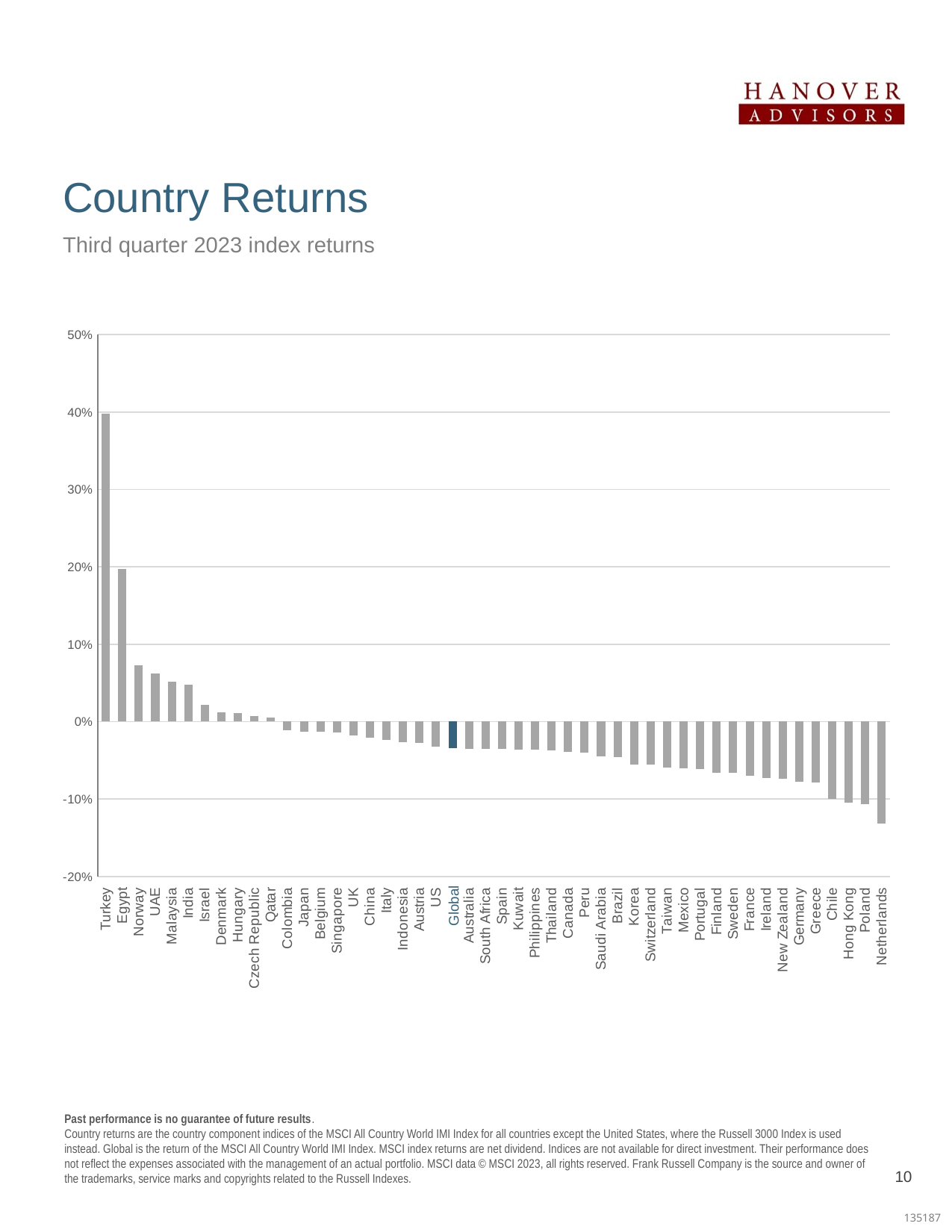
Is the value for Norway greater or less than 10%? less Which has the larger return, Turkey or Egypt? Turkey Which bar is shown in a different (dark blue) colour from the others? Global Do the values rise or fall moving from left to right along the x axis? fall What kind of chart is shown on the slide? bar chart Which country has the highest third quarter 2023 index return? Turkey Is the value for Global greater or less than 0%? less Is the value for Egypt greater or less than 10%? greater How many bars are plotted in the chart? 48 Which country has the lowest third quarter 2023 index return? Netherlands